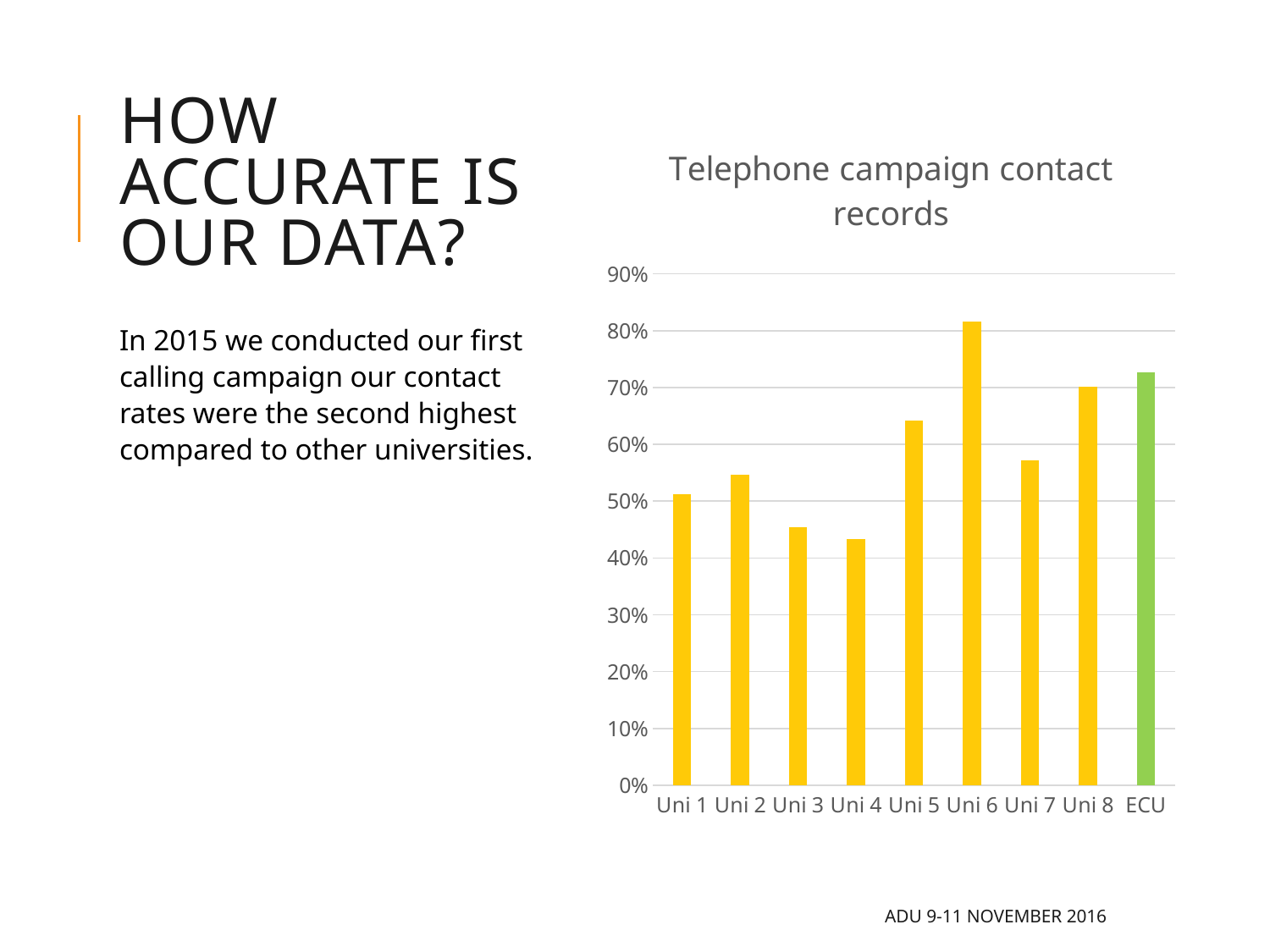
Is the value for Uni 7 greater or less than 60%? less Is the value for Uni 6 greater or less than 70%? greater What is the title of the chart? Telephone campaign contact records Which has the larger value, Uni 6 or ECU? Uni 6 Is the value for ECU greater or less than 60%? greater Which bar in the chart is coloured differently (green) from the others? ECU Which university has the highest contact rate in the chart? Uni 6 Which has the larger value, Uni 5 or Uni 7? Uni 5 How many universities (categories) are shown on the x axis of the chart? 9 What kind of chart is shown on the slide? bar chart